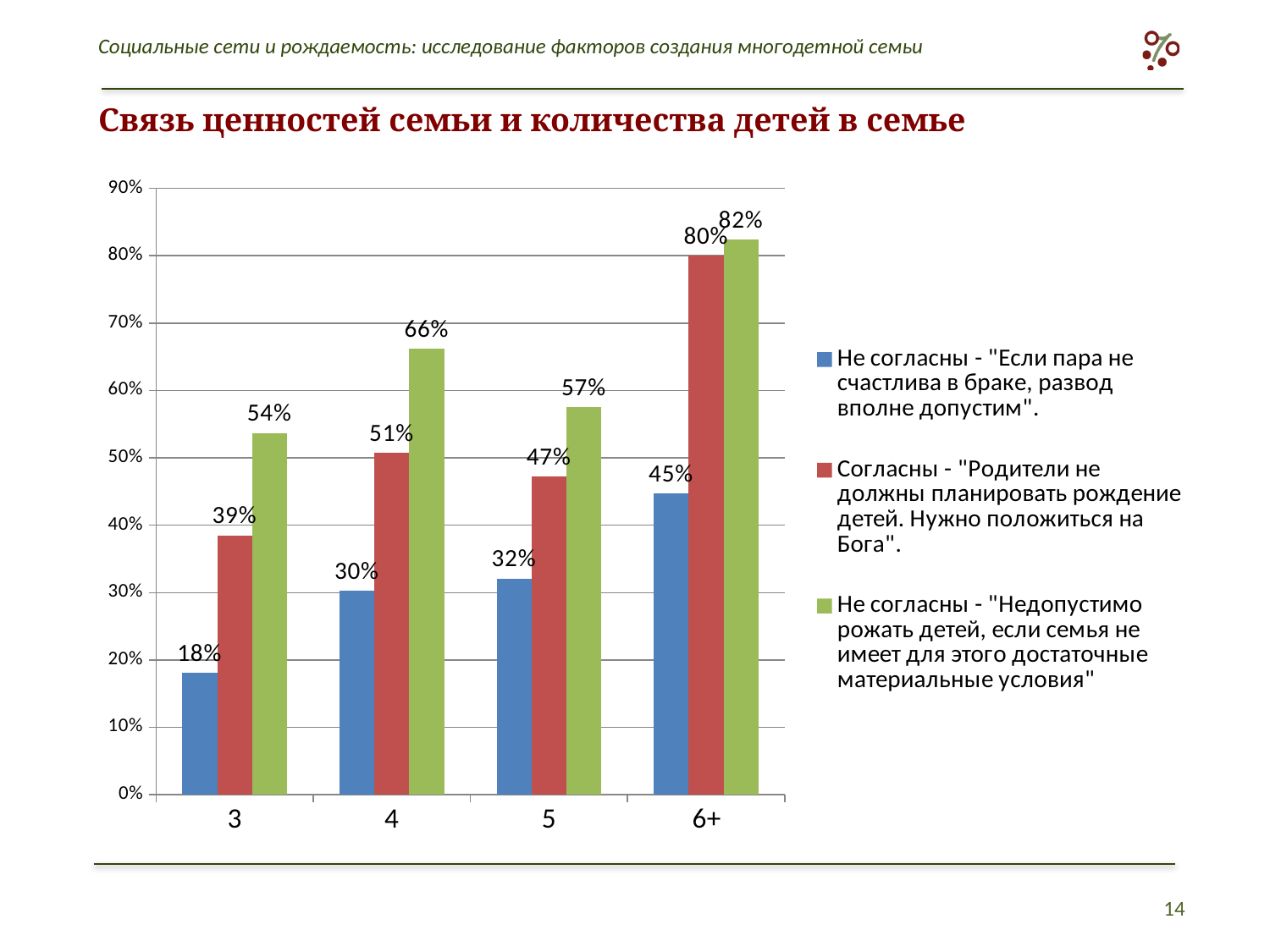
What is the title of the chart on the slide? Связь ценностей семьи и количества детей в семье How many categories are shown on the x axis? 4 What kind of chart is shown on the slide? bar chart What is the value of the red series (Согласны - "Родители не должны планировать рождение детей...") for category 6+? 80% For category 4, which is larger: the red series value or the green series value? the green series (66%) What is the value of the green series (Не согласны - "Недопустимо рожать детей...") for category 4? 66% What is the difference between the green and blue values for category 5? 25% How many series does the legend list? 3 What is the value of the blue series (Не согласны - "Если пара не счастлива в браке, развод вполне допустим") for category 3? 18% Does the blue series rise or fall as the number of children increases from 3 to 6+? rises Which category has the lowest value for the blue series? 3 Which category has the highest value for the green series? 6+